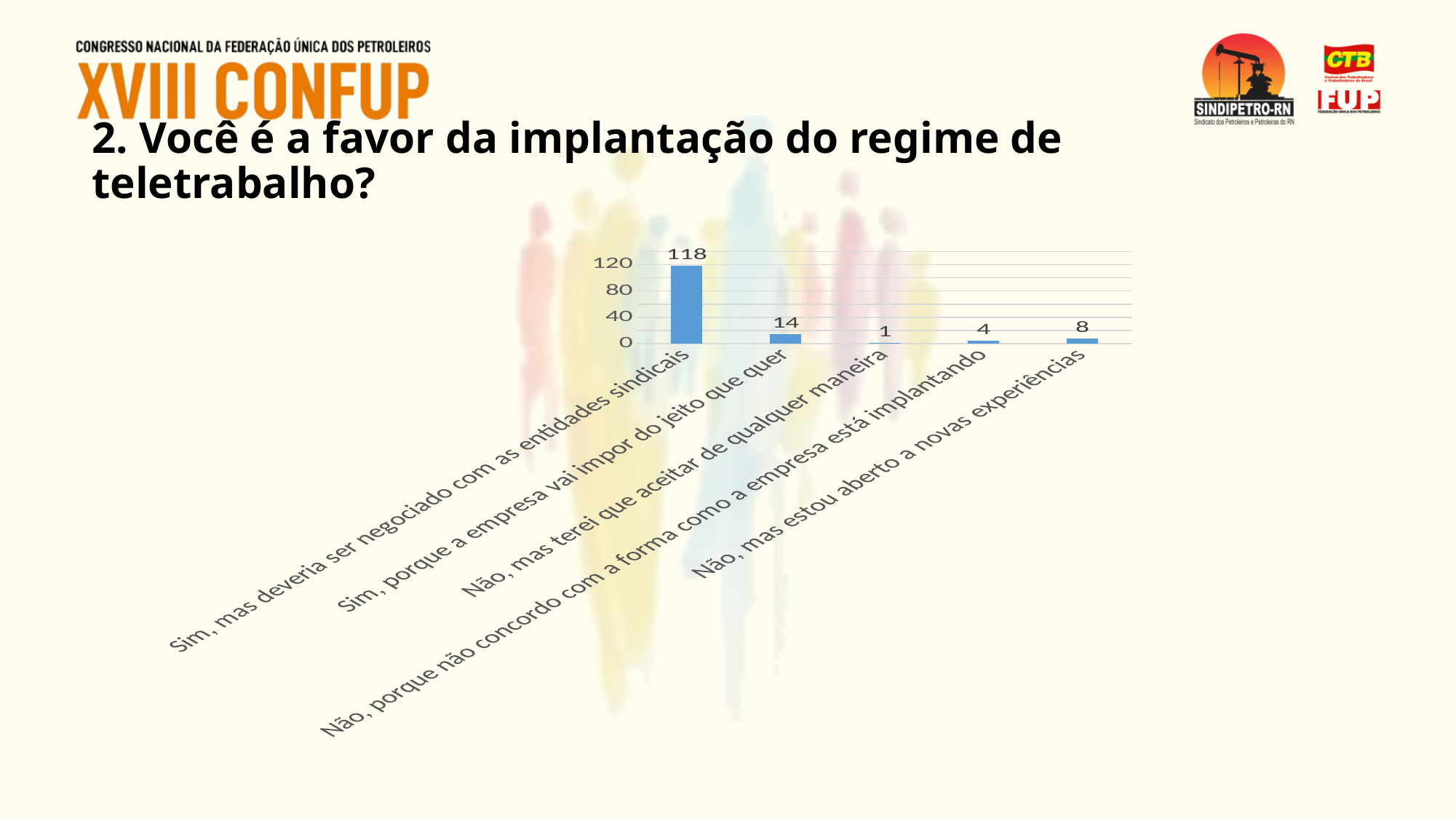
What is the value for "Não, mas terei que aceitar de qualquer maneira"? 1 Which category has the lowest value? Não, mas terei que aceitar de qualquer maneira What is the value for "Não, porque não concordo com a forma como a empresa está implantando"? 4 Which category has the highest value? Sim, mas deveria ser negociado com as entidades sindicais Which is larger: the value for "Não, mas estou aberto a novas experiências" or the value for "Não, porque não concordo com a forma como a empresa está implantando"? Não, mas estou aberto a novas experiências What is the value for "Não, mas estou aberto a novas experiências"? 8 What is the difference between the values for "Sim, mas deveria ser negociado com as entidades sindicais" and "Sim, porque a empresa vai impor do jeito que quer"? 104 What is the value for "Sim, porque a empresa vai impor do jeito que quer"? 14 Is the value for "Sim, mas deveria ser negociado com as entidades sindicais" greater or less than 80? greater What is the value for "Sim, mas deveria ser negociado com as entidades sindicais"? 118 What kind of chart is shown on the slide? bar chart How many categories are shown in the chart? 5